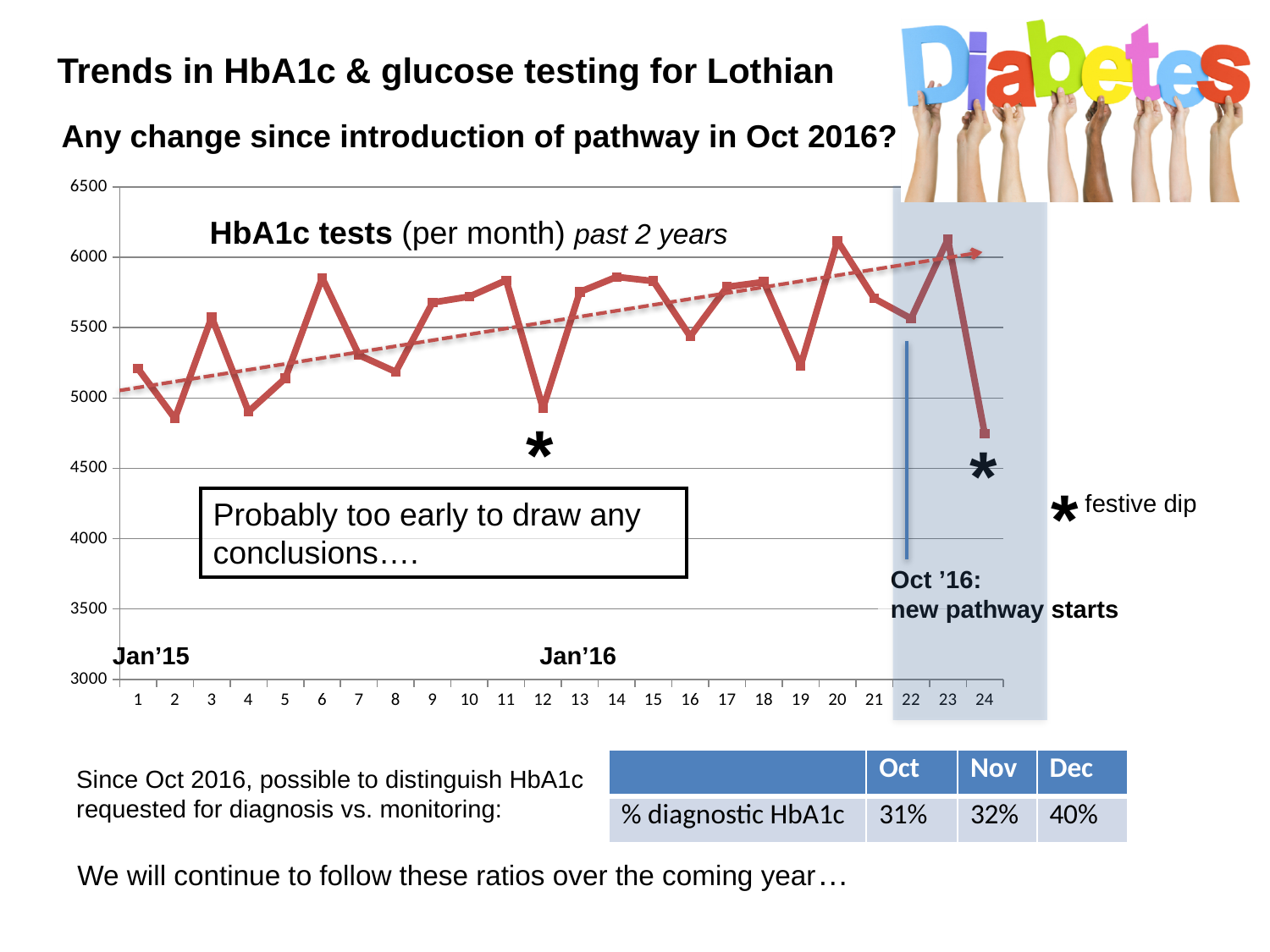
How many monthly data points are plotted on the HbA1c tests chart? 24 Is the value for month 1 greater or less than 5000? greater What is the title of the chart? HbA1c tests (per month) past 2 years Is the value for month 23 greater or less than 6000? greater Is the value for month 19 greater or less than 5500? less Which has the higher value, month 6 or month 7? month 6 Which has the lower value, month 12 or month 13? month 12 According to the slide, what do the asterisks on the chart mark? festive dip What kind of chart is shown on the slide? line chart Does the dashed trend line rise or fall from month 1 to month 24? rises